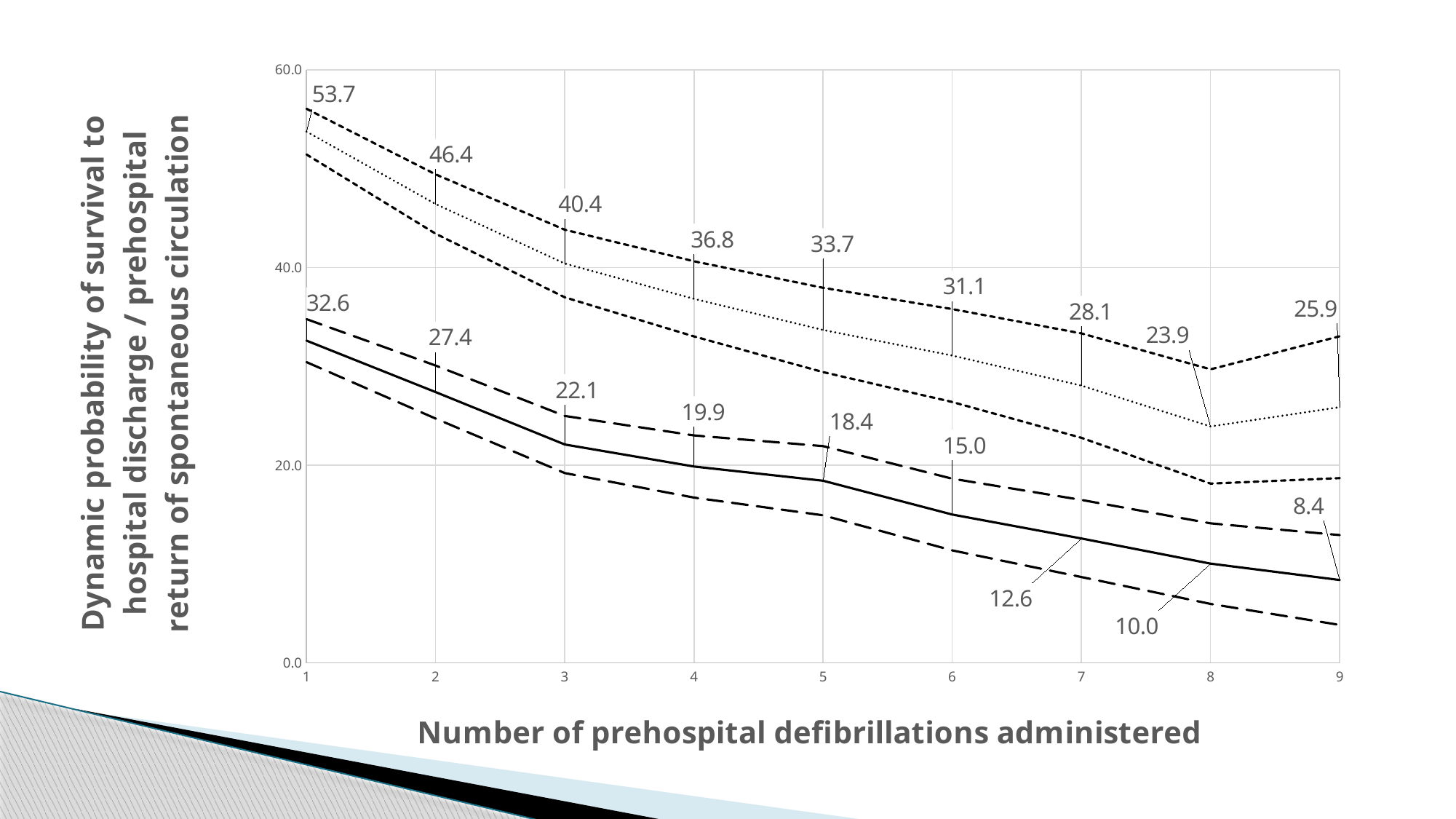
What is the difference between the upper dotted line (53.7) and the lower solid line (32.6) at 1 prehospital defibrillation? 21.1 Which is larger for the upper dotted line: the value at 8 defibrillations or at 9 defibrillations? 9 defibrillations (25.9) What is the labelled value of the lower solid line at 9 prehospital defibrillations? 8.4 What is the labelled value of the lower solid line at 3 prehospital defibrillations? 22.1 At which number of prehospital defibrillations is the upper dotted line lowest? 8 At which number of prehospital defibrillations is the upper dotted line highest? 1 What is the labelled value of the upper dotted line at 9 prehospital defibrillations? 25.9 Does the lower solid line rise or fall as the number of prehospital defibrillations increases from 1 to 9? Falls What kind of chart is shown on the slide? Line chart What is the labelled value of the upper dotted line at 1 prehospital defibrillation? 53.7 How many values of number of prehospital defibrillations are shown on the x axis? 9 What is the title of the x axis? Number of prehospital defibrillations administered